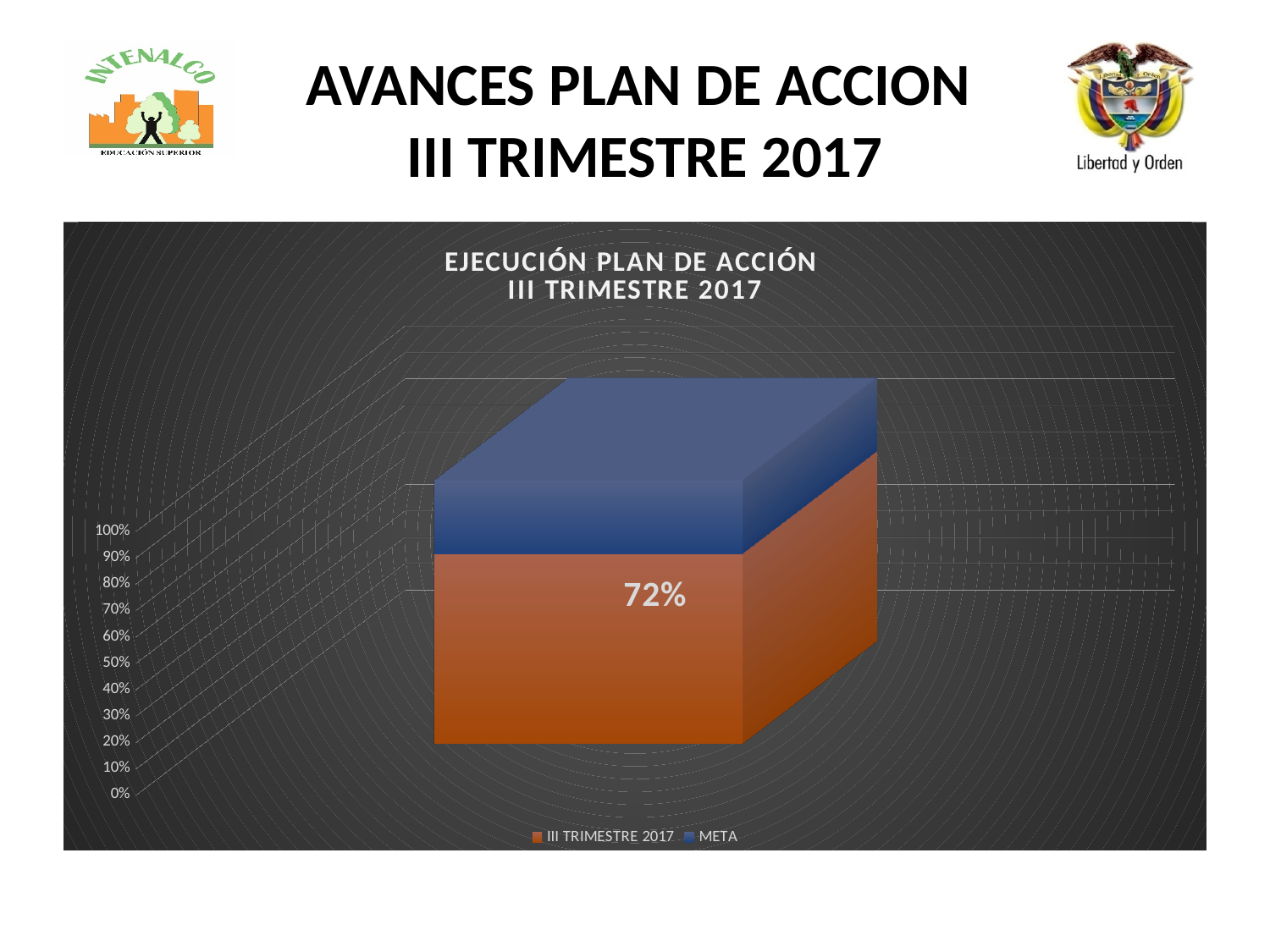
What is the title of the chart? EJECUCIÓN PLAN DE ACCIÓN III TRIMESTRE 2017 What kind of chart is shown on the slide? Bar chart What is the value shown for the III TRIMESTRE 2017 series? 72% Which series is shown in blue in the legend? META Is the value for III TRIMESTRE 2017 greater or less than 50%? greater How many series does the legend list? 2 How many stacked bars are plotted in the chart? 1 Is the value for III TRIMESTRE 2017 greater or less than 80%? less What is the highest value labelled on the vertical axis? 100%